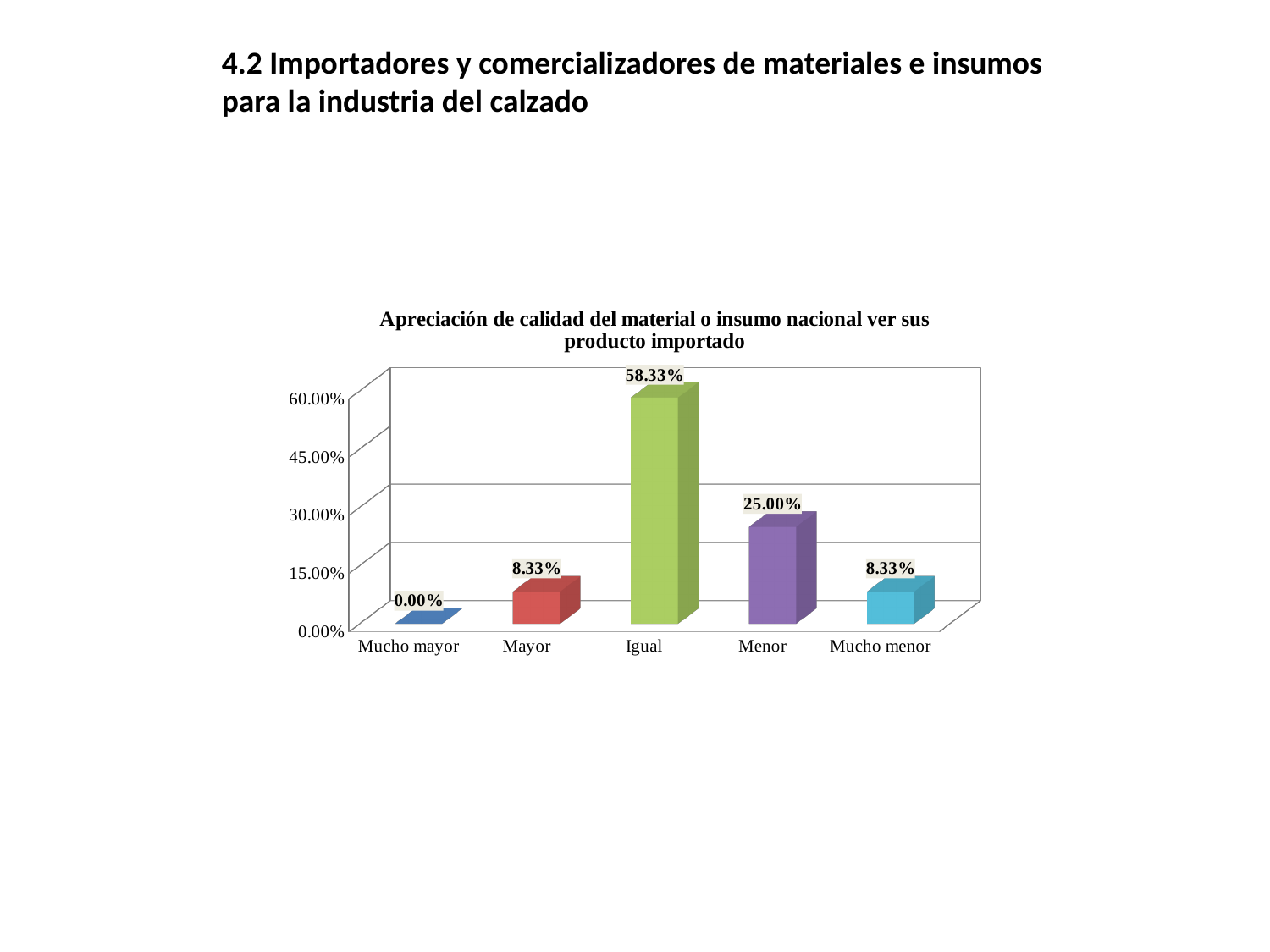
Which category has the lowest value? Mucho mayor What kind of chart is shown on the slide? bar chart Which category has the highest value? Igual What is the title of the chart? Apreciación de calidad del material o insumo nacional ver sus producto importado What is the value for Menor? 25.00% Which is larger, the value for Menor or the value for Mucho menor? Menor What is the difference between the values for Igual and Menor? 33.33% How many categories are shown on the x axis? 5 What is the value for Igual? 58.33% Is the value for Menor greater or less than 30.00%? less What is the value for Mayor? 8.33% What is the value for Mucho mayor? 0.00%